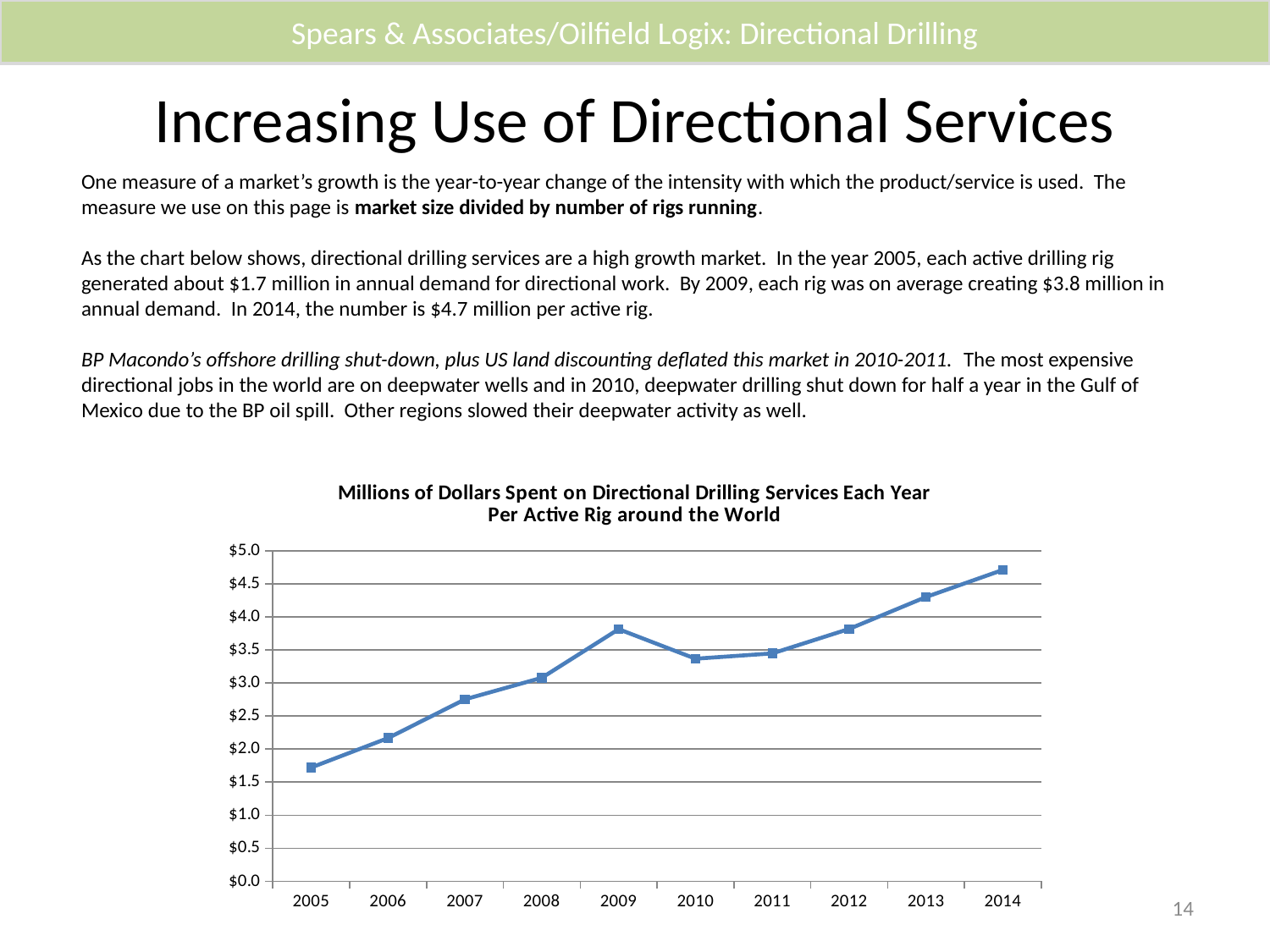
What kind of chart is shown on the slide? line chart Is the value for 2007 greater or less than $2.5? greater Is the value for 2009 greater or less than $4.0? less Is the value for 2013 greater or less than $4.0? greater What is the title of the chart? Millions of Dollars Spent on Directional Drilling Services Each Year Per Active Rig around the World How many years are plotted on the x axis of the chart? 10 Which year has the larger value, 2009 or 2010? 2009 Which year has the highest value in the chart? 2014 Do the values generally rise or fall from 2005 to 2014? rise Which year has the lowest value in the chart? 2005